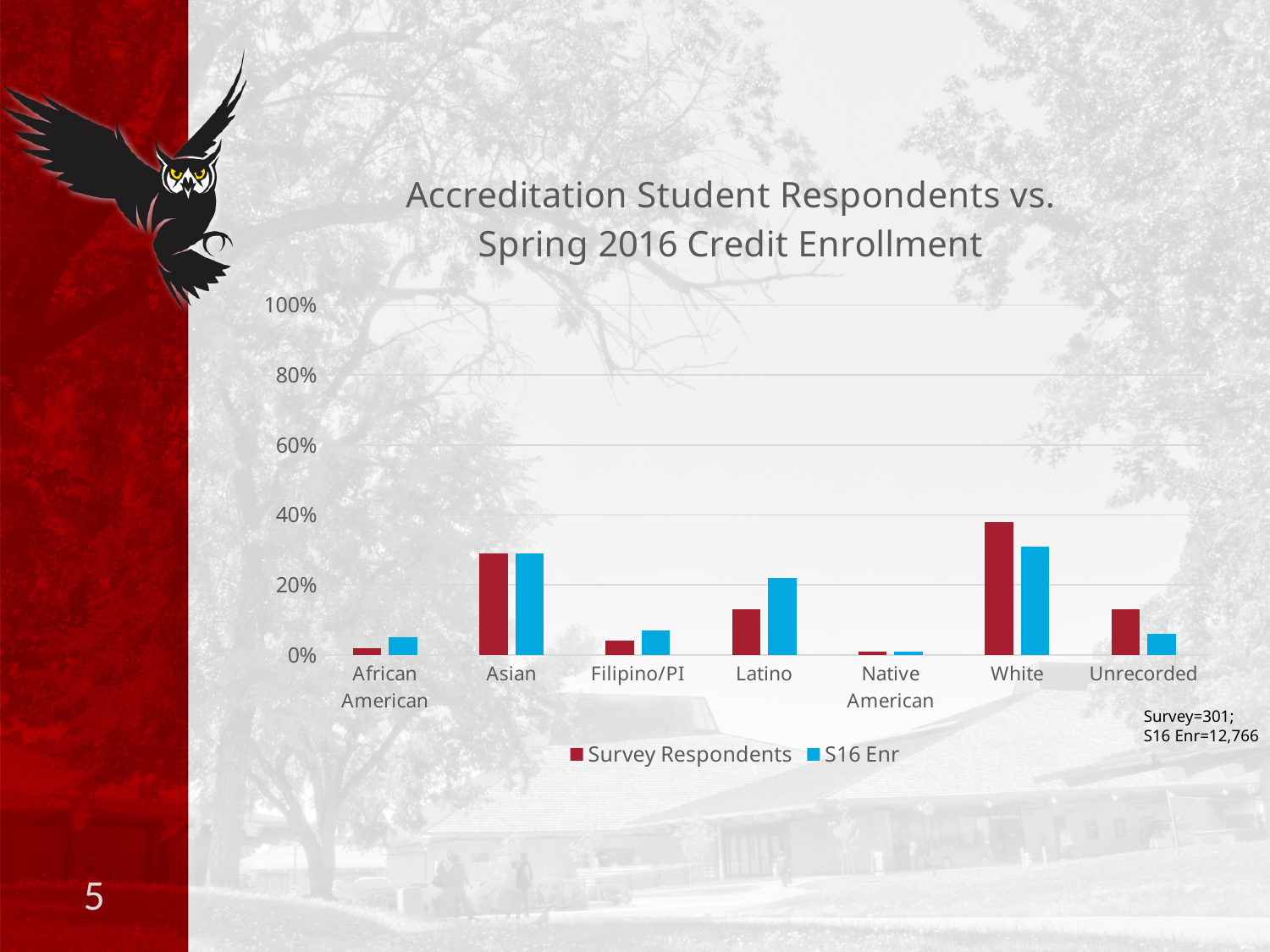
Is the Survey Respondents value for White greater or less than 20%? greater Is the S16 Enr value for Latino greater or less than 40%? less What is the title of the chart? Accreditation Student Respondents vs. Spring 2016 Credit Enrollment Which category has the lowest S16 Enr value? Native American Which category has the highest Survey Respondents value? White What type of chart is shown on the slide? bar chart For Unrecorded, which is larger: Survey Respondents or S16 Enr? Survey Respondents Which series is shown in red in the chart? Survey Respondents Is the Survey Respondents value for Asian greater or less than 20%? greater How many categories are shown on the x axis of the chart? 7 How many series does the chart's legend list? 2 For Latino, which is larger: Survey Respondents or S16 Enr? S16 Enr